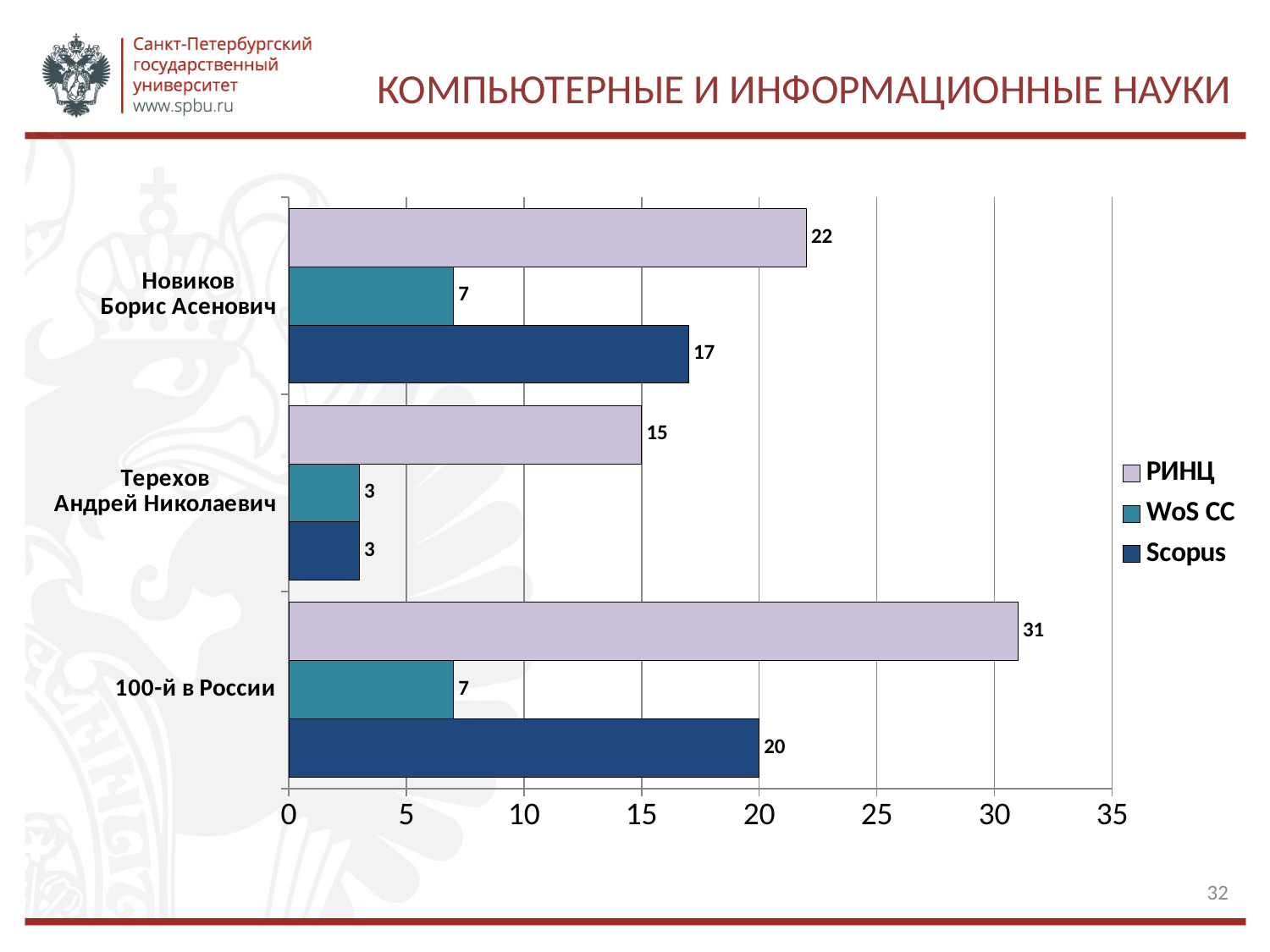
What is the difference between the РИНЦ value and the Scopus value for Новиков Борис Асенович? 5 What is the WoS CC value for 100-й в России? 7 What is the РИНЦ value for Новиков Борис Асенович? 22 Which category has the highest РИНЦ value? 100-й в России What is the title of the slide? КОМПЬЮТЕРНЫЕ И ИНФОРМАЦИОННЫЕ НАУКИ Which category has the lowest Scopus value? Терехов Андрей Николаевич How many series does the legend list? 3 What is the Scopus value for Терехов Андрей Николаевич? 3 What kind of chart is shown on the slide? bar chart What is the difference between the РИНЦ value for 100-й в России and the РИНЦ value for Терехов Андрей Николаевич? 16 How many categories are shown on the chart? 3 Which is larger: the Scopus value for Новиков Борис Асенович or the Scopus value for 100-й в России? 100-й в России